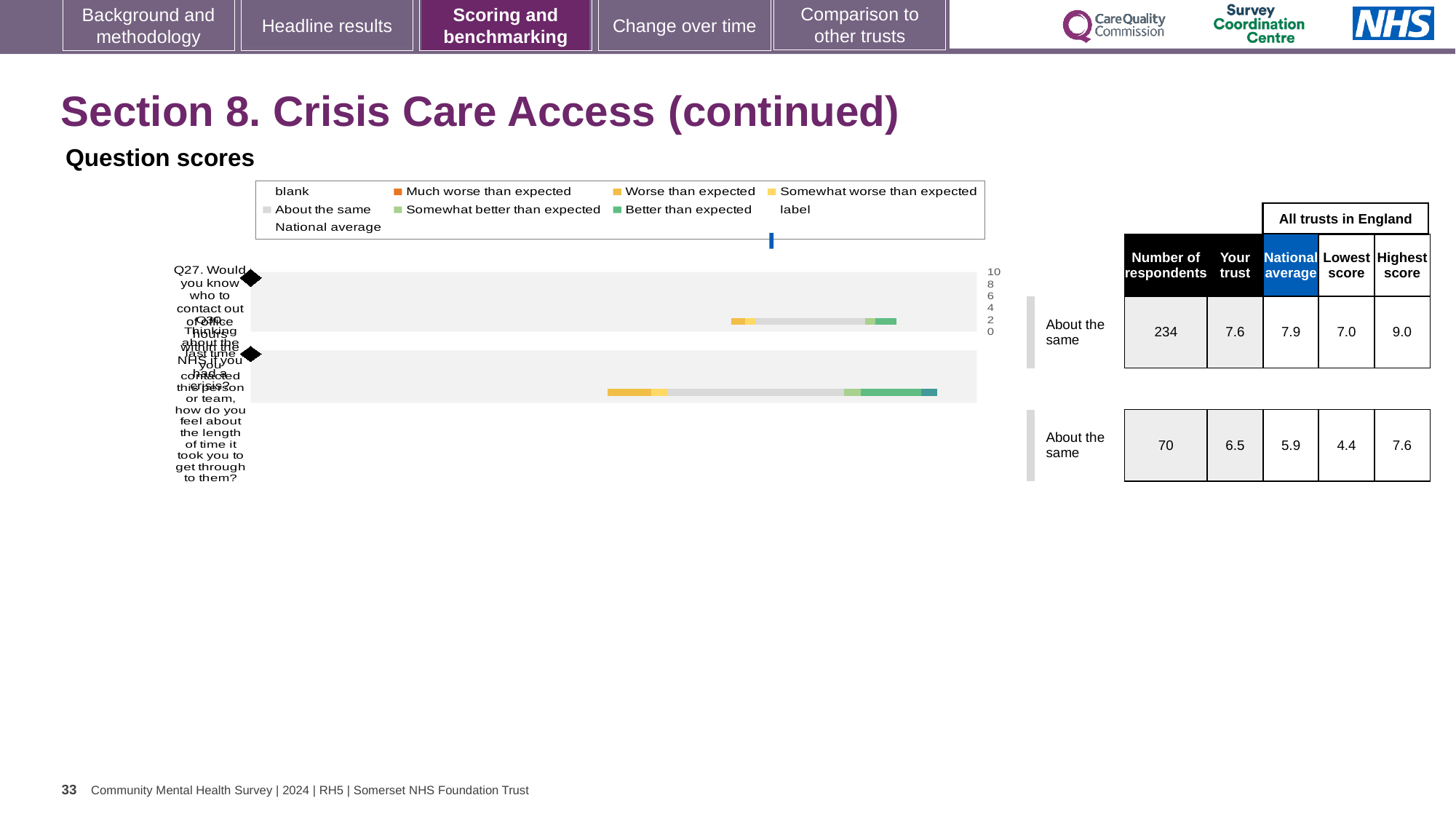
For Q28, which is larger: the 'Your trust' score or the national average? Your trust What is the 'Your trust' score for Q27 (Would you know who to contact out of office hours within the NHS if you had a crisis?)? 7.6 Which question has the higher 'Your trust' score, Q27 or Q28? Q27 What kind of chart is used to show the question scores on this slide? bar chart What is the lowest score across all trusts in England for Q28? 4.4 What benchmark category is shown for Q27 in the question scores chart? About the same How many respondents answered Q28 (how do you feel about the length of time it took you to get through to them)? 70 For Q27, which is larger: the 'Your trust' score or the national average? National average How many questions are plotted in the question scores chart? 2 What is the difference between the highest score and the lowest score for Q27? 2.0 What is the national average score for Q27? 7.9 What is the difference between the highest score and the lowest score for Q28? 3.2